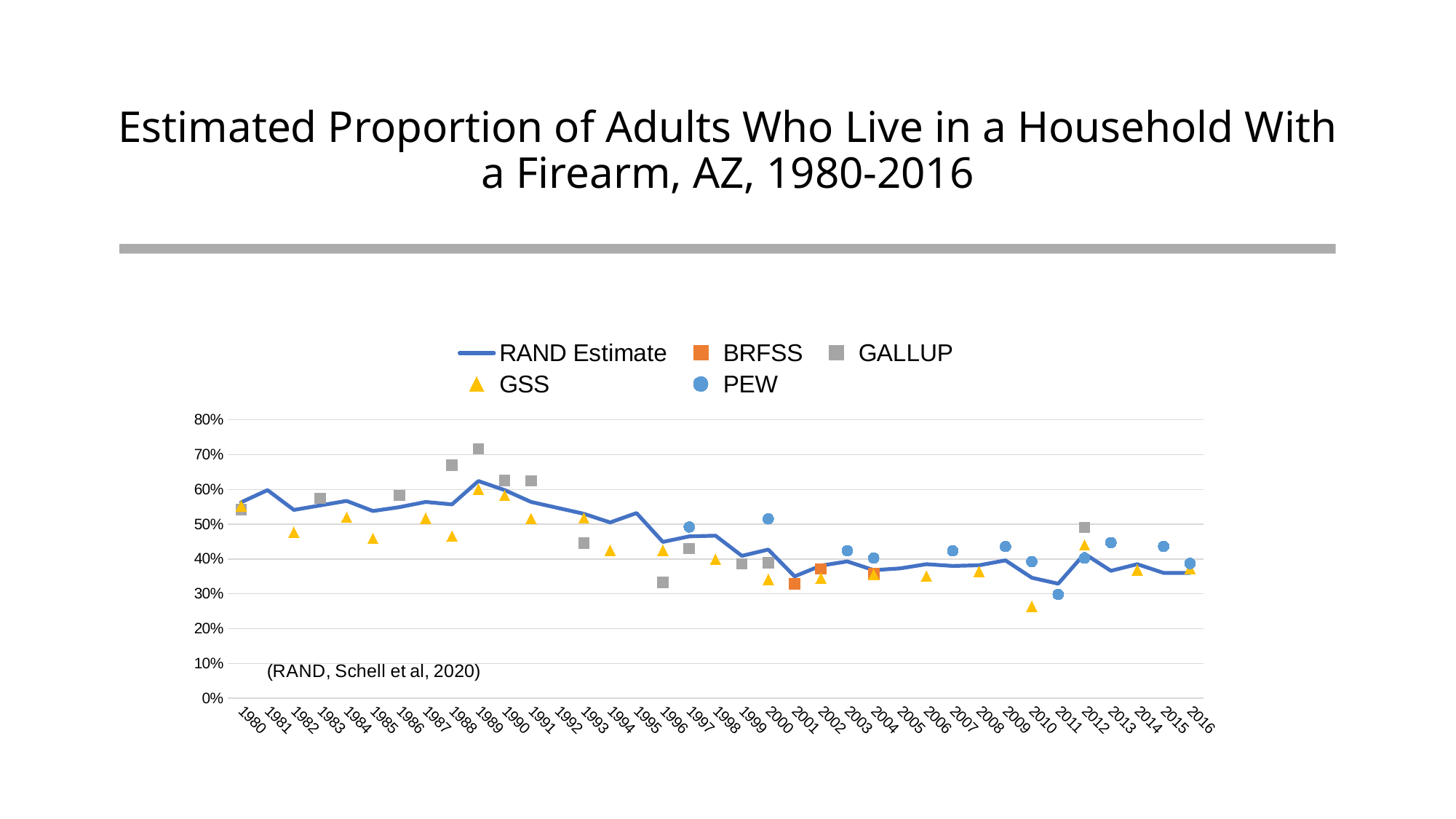
Does the RAND Estimate line generally rise or fall from 1980 to 2016? Fall What kind of chart is shown on the slide? Line chart Is the RAND Estimate value for 2016 greater or less than 40%? less What source citation is printed inside the chart area? (RAND, Schell et al, 2020) Is the GALLUP value for 1988 greater or less than 60%? greater In which year does the GALLUP series reach its highest value? 1989 How many series does the legend list? 5 Which is larger, the RAND Estimate for 1980 or the RAND Estimate for 2016? 1980 Is the GSS value for 2010 greater or less than 30%? less How many BRFSS data points are plotted on the chart? 3 In which year does the GSS series have its lowest value? 2010